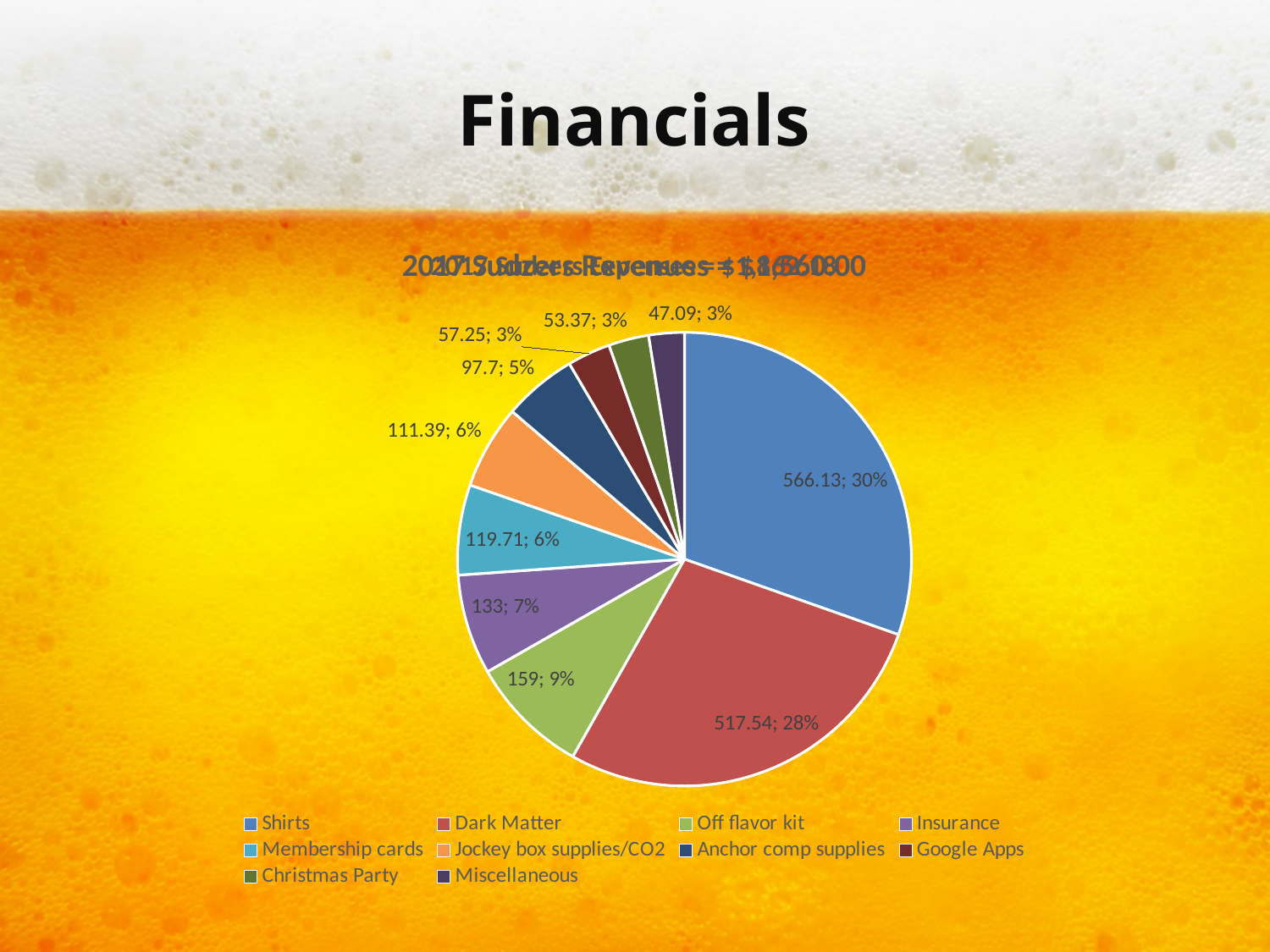
Which category has the smallest slice of the pie? Miscellaneous Which is larger, the value for Insurance or the value for Jockey box supplies/CO2? Insurance Which category has the largest slice of the pie? Shirts What colour is the slice for Dark Matter? red What is the value shown for Off flavor kit? 159 What percentage share of the pie does Dark Matter have? 28% What percentage share of the pie does Anchor comp supplies have? 5% What is the value shown for Shirts in the pie chart? 566.13 What is the difference between the values for Shirts and Dark Matter? 48.59 How many categories does the legend of the pie chart list? 10 What is the value shown for Membership cards? 119.71 What kind of chart is shown on the slide? pie chart